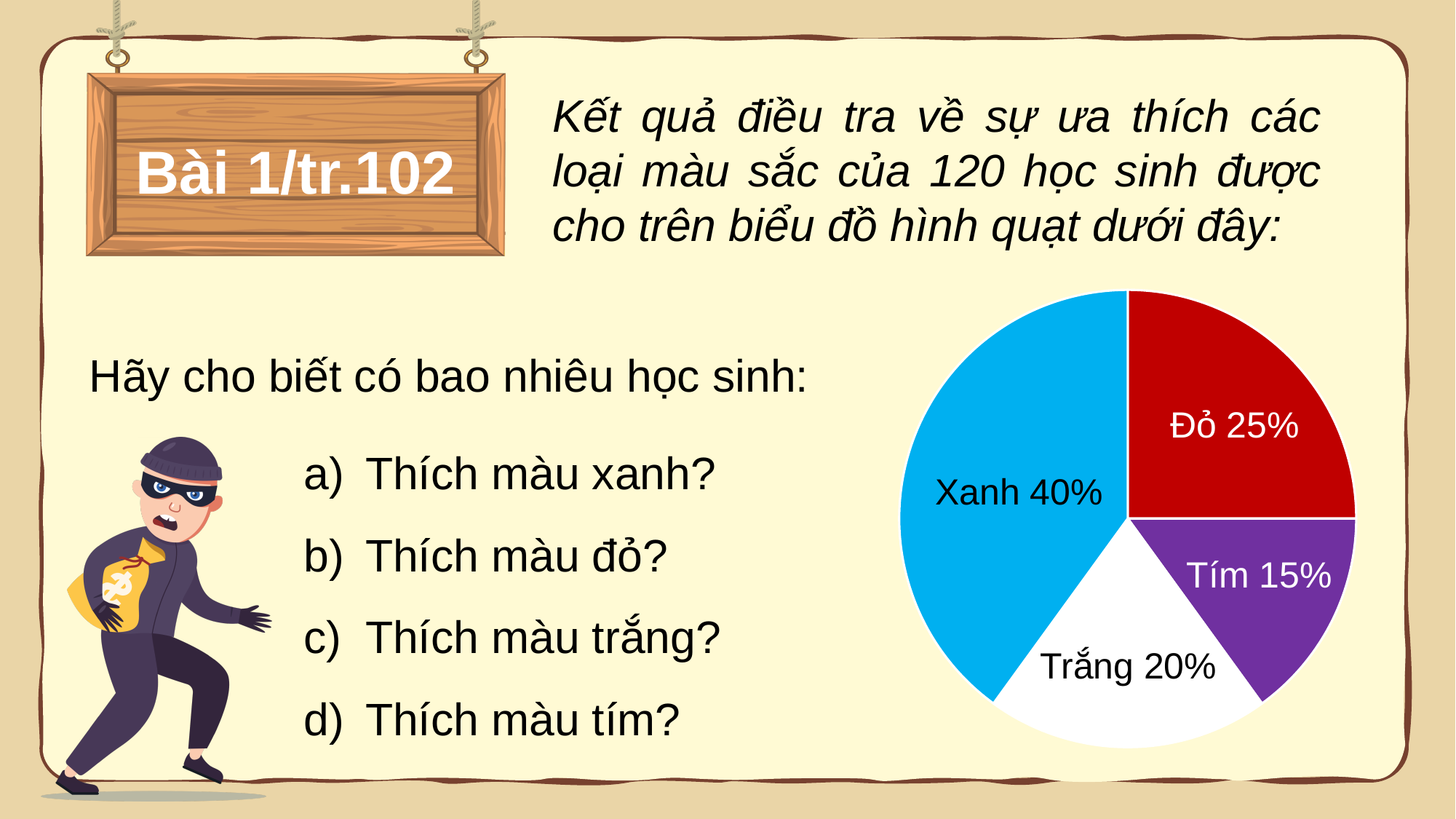
How many slices does the pie chart have? 4 Which colour category has the largest slice of the pie chart? Xanh What percentage of the pie chart is labelled Tím? 15% Which colour category has the smallest slice of the pie chart? Tím What percentage of the pie chart is labelled Xanh? 40% What percentage of the pie chart is labelled Đỏ? 25% Which slice is larger, Đỏ or Trắng? Đỏ What is the difference in percentage points between the Trắng slice and the Tím slice? 5% What kind of chart is shown on the slide? Pie chart What is the difference in percentage points between the Xanh slice and the Đỏ slice? 15% What colour is the slice labelled Tím 15% in the pie chart? Purple What percentage of the pie chart is labelled Trắng? 20%